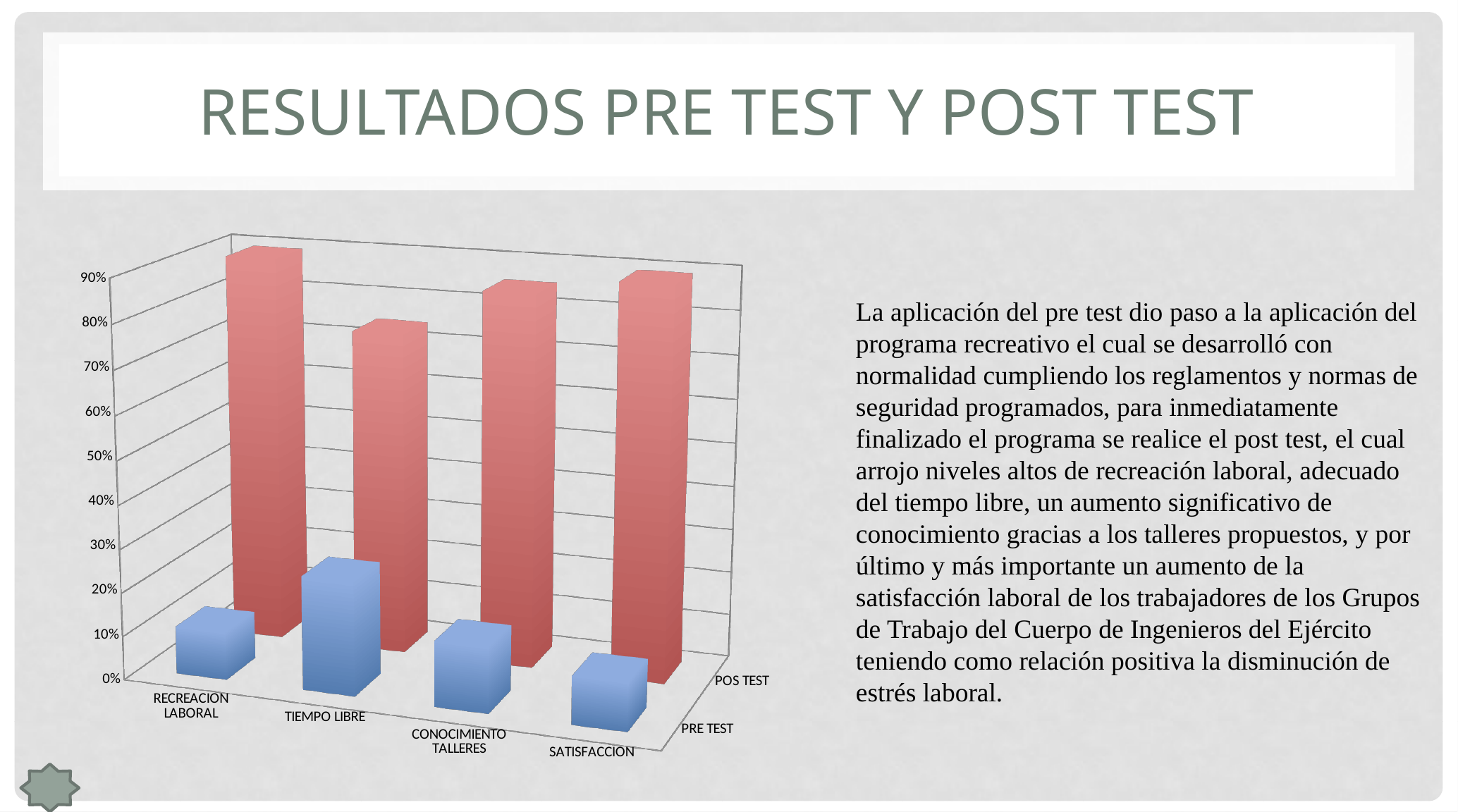
How many categories are shown on the chart's category axis? 4 Is the PRE TEST value for TIEMPO LIBRE greater or less than 50%? less What kind of chart is shown on the slide? Bar chart Which category has the lowest POS TEST value? TIEMPO LIBRE What is the highest percentage label shown on the chart's vertical axis? 90% Which category has the highest PRE TEST value? TIEMPO LIBRE Is the POS TEST value for RECREACION LABORAL greater or less than 50%? greater Which series has the higher value for TIEMPO LIBRE, PRE TEST or POS TEST? POS TEST What colour are the POS TEST bars in the chart? Red Is the PRE TEST value for SATISFACCION greater or less than 30%? less How many series does the chart plot? 2 Which series has the higher value for SATISFACCION, PRE TEST or POS TEST? POS TEST